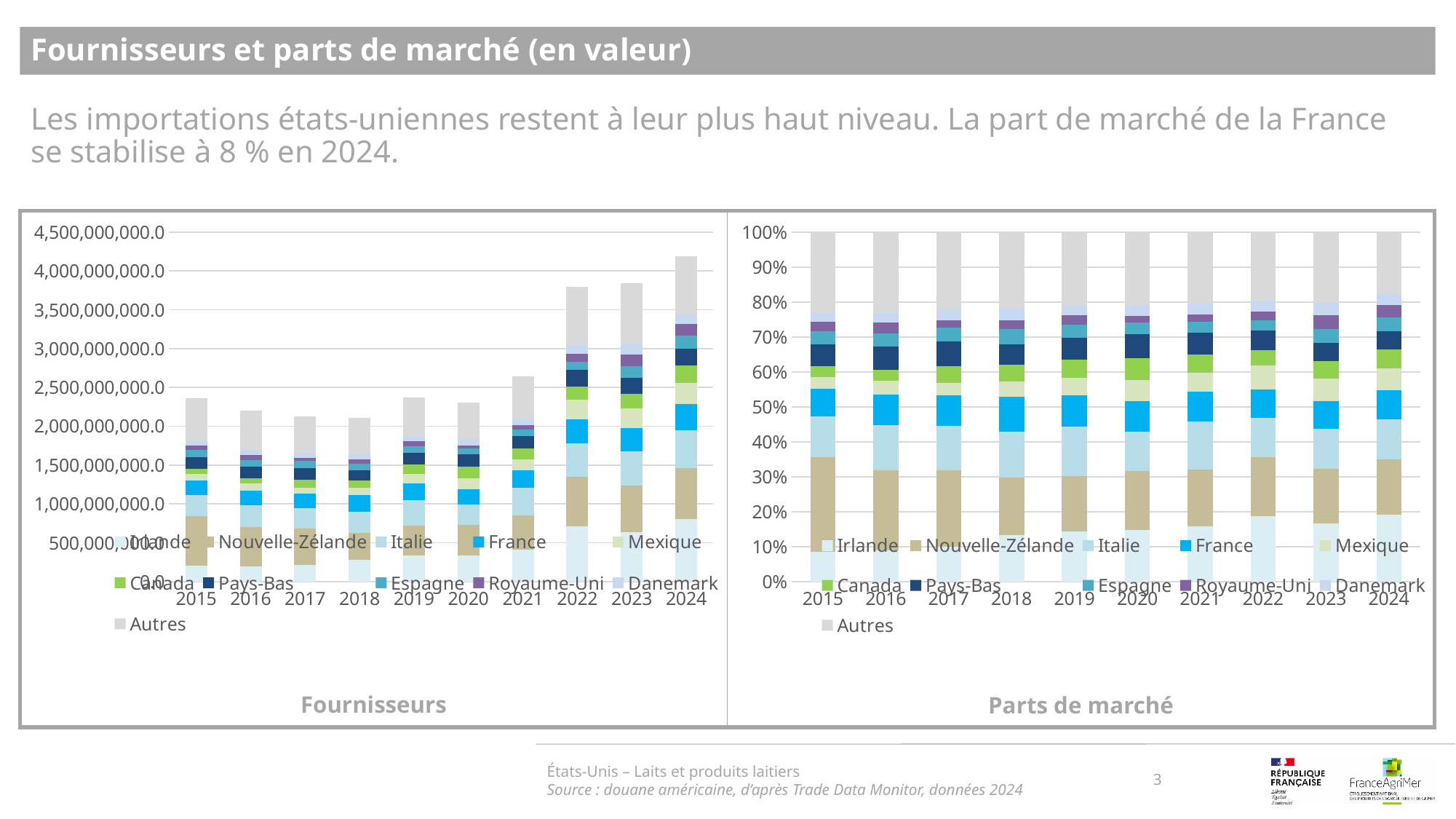
In the 'Fournisseurs' chart, is the total for 2022 greater or less than 3,500,000,000.0? greater Which series is shown in grey at the top of the stacked bars in both charts? Autres How many series does the legend of the 'Parts de marché' chart list? 11 In the 'Fournisseurs' chart, do the total bars rise or fall from 2021 to 2024? rise What is the title of the chart on the right? Parts de marché In the 'Fournisseurs' chart, is the total for 2024 greater or less than 4,000,000,000.0? greater In the 'Fournisseurs' chart, which total bar is larger, 2021 or 2022? 2022 In the 'Parts de marché' chart, is the Irlande share in 2024 greater or less than 10%? greater What kind of chart is the 'Fournisseurs' chart on the left? Stacked bar chart In the 'Fournisseurs' chart, which year has the highest total bar? 2024 How many years are shown on the x axis of the 'Fournisseurs' chart? 10